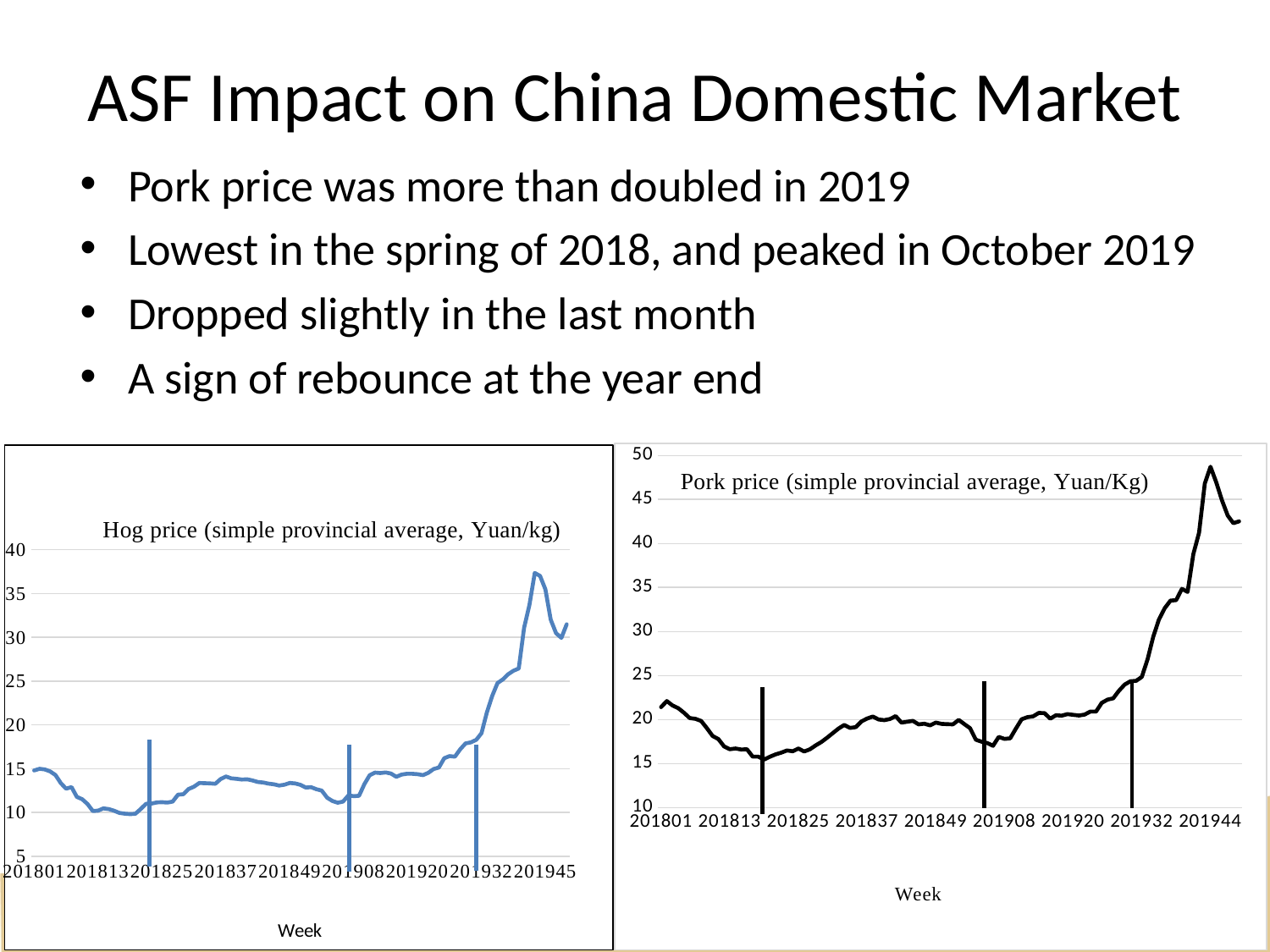
In the Pork price chart, is the value at week 201813 greater or less than 20? less In the Hog price chart, is the peak value reached in 2019 greater or less than 35? greater In the Pork price chart, does the price rise or fall between week 201932 and week 201944? rise What is the full title of the chart on the right? Pork price (simple provincial average, Yuan/Kg) In the Hog price chart, is the value at week 201932 greater or less than 15? greater What kind of chart is the Pork price chart on the right? line chart What is the x-axis label on the Hog price chart? Week What kind of chart is the Hog price chart on the left? line chart In the Hog price chart, is the price at the end of 2019 higher or lower than at the start of 2018? higher